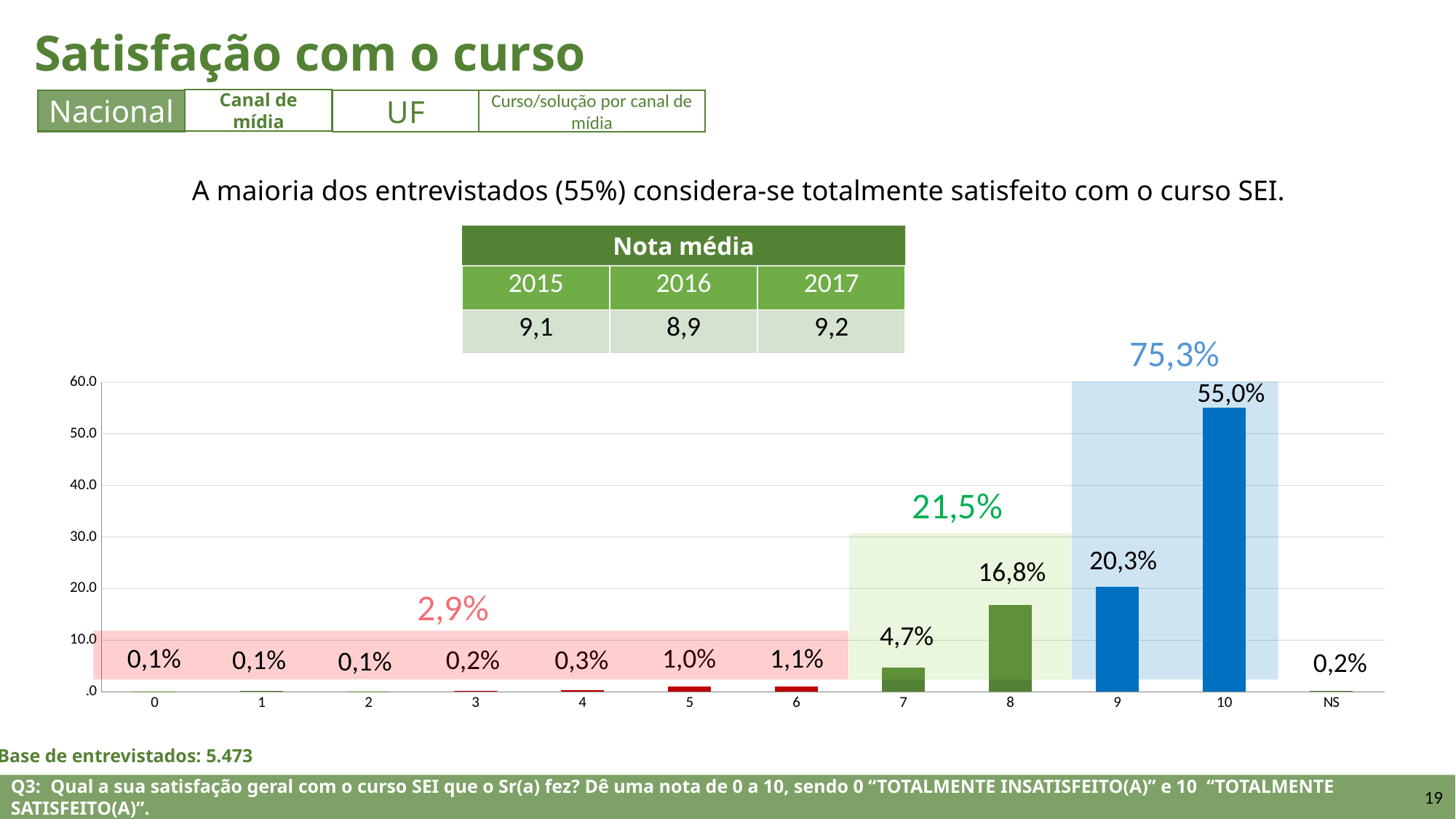
What is the value for score 10? 55,0% Which is larger, the value for score 8 or the value for score 9? score 9 What is the value for score 8? 16,8% Is the value for score 10 greater or less than 50? greater What is the value for score 7? 4,7% Which score has the highest value? 10 How many categories are shown on the x axis? 12 What kind of chart is shown on the slide? bar chart What is the difference between the values for score 9 and score 8? 3,5% What is the value for NS? 0,2% What is the value for score 9? 20,3% What is the difference between the values for score 10 and score 9? 34,7%